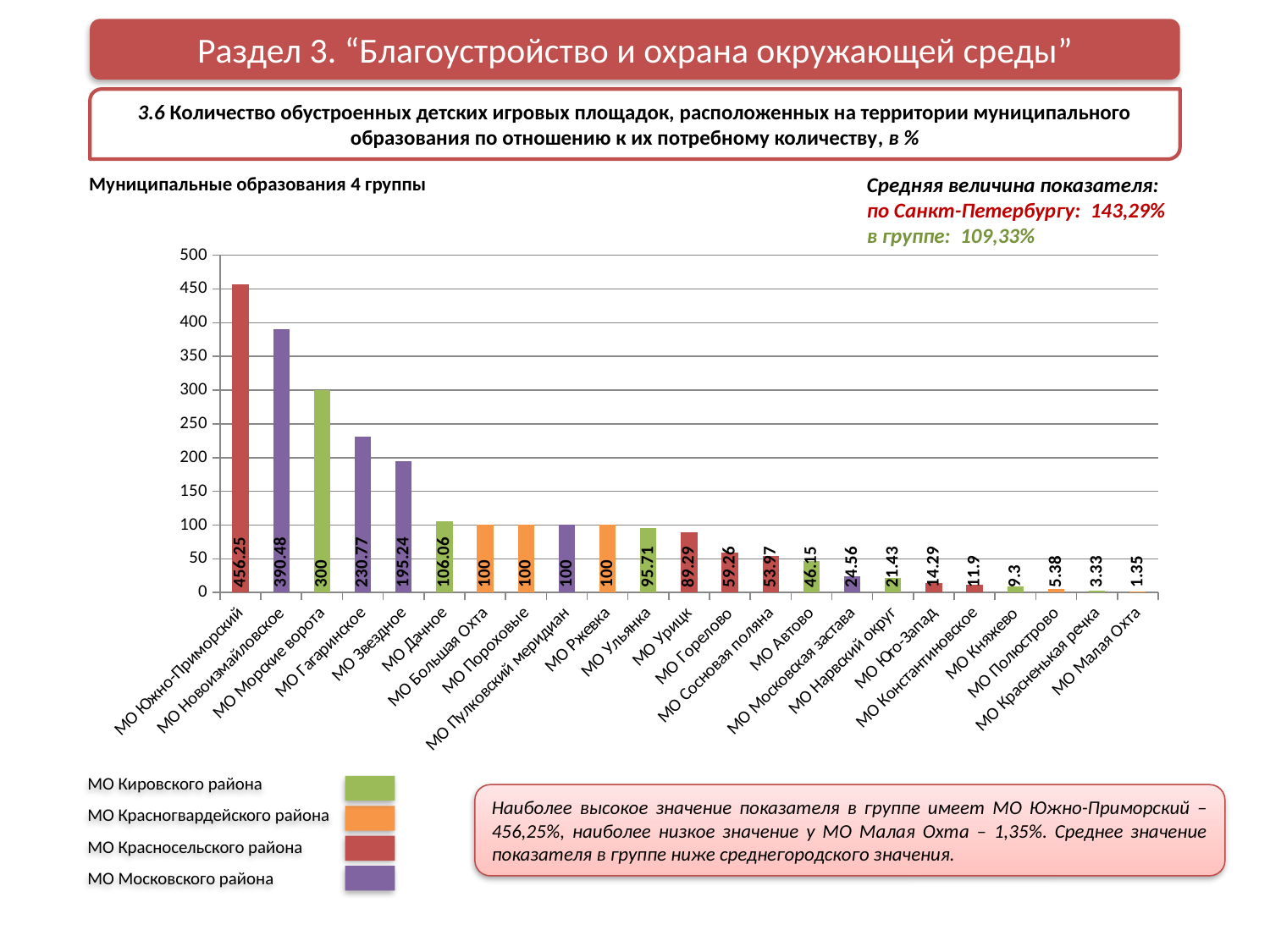
Is the value for МО Новоизмайловское greater or less than 350? greater What is the value for МО Автово? 46.15 Which municipality has the highest value on the chart? МО Южно-Приморский What is the value for МО Ульянка? 95.71 What is the value for МО Гагаринское? 230.77 Which municipality has the lowest value on the chart? МО Малая Охта Which is larger, the value for МО Звездное or the value for МО Урицк? МО Звездное How many entries does the legend list? 4 How many municipalities are shown on the chart? 23 What is the difference between the values for МО Морские ворота and МО Дачное? 193.94 What kind of chart is shown on the slide? bar chart What is the difference between the values for МО Южно-Приморский and МО Новоизмайловское? 65.77